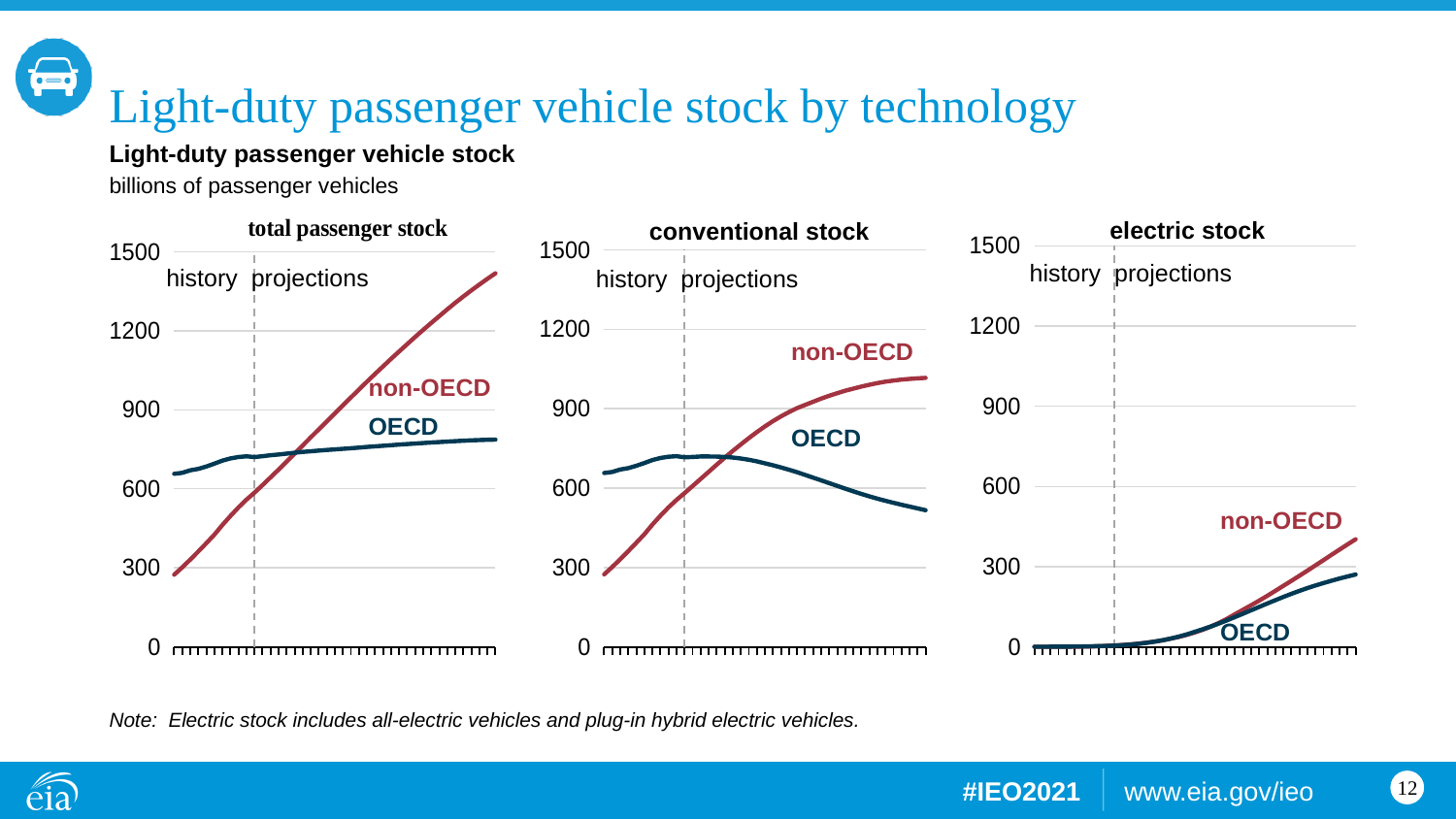
What unit are the values on the charts measured in? billions of passenger vehicles In the 'total passenger stock' chart, is the non-OECD value at the end of the projection period greater or less than 1200? greater How many series does the 'conventional stock' chart show? 2 How many charts are shown on the slide? 3 In the 'total passenger stock' chart, is the OECD value at the end of the projection period greater or less than 900? less In the 'electric stock' chart, does the non-OECD line rise or fall over the projection period? rise In the 'conventional stock' chart, is the OECD value at the end of the projection period greater or less than 600? less In the 'conventional stock' chart, does the OECD line rise or fall over the projection period? fall In the 'total passenger stock' chart, which series is higher at the end of the projection period, OECD or non-OECD? non-OECD In the 'conventional stock' chart, which series is higher at the start of the history period, OECD or non-OECD? OECD What kind of chart is the 'total passenger stock' chart? line chart